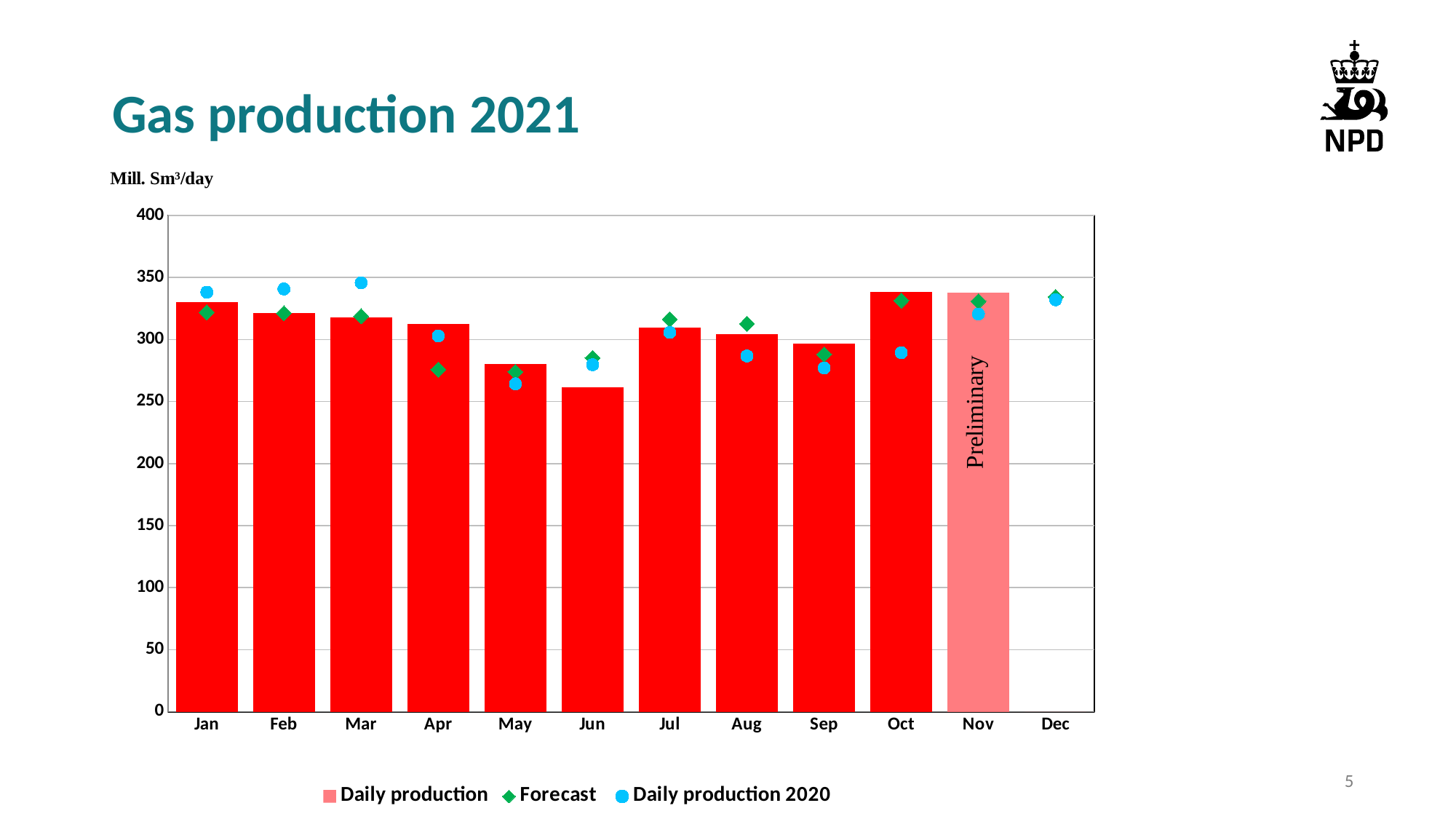
Do the daily production bars rise or fall from Jan to Jun? fall How many series does the legend list? 3 Which month has the lowest daily production bar? Jun How many months are shown on the x axis? 12 What word is written on the Nov bar? Preliminary Is the daily production bar for Oct greater or less than 300? greater Is the daily production bar for May greater or less than 300? less What kind of chart is shown on the slide? bar chart What unit is shown above the y axis? Mill. Sm³/day Is the daily production bar for Jan greater or less than 300? greater Which is larger, the daily production bar for Jan or for Jun? Jan